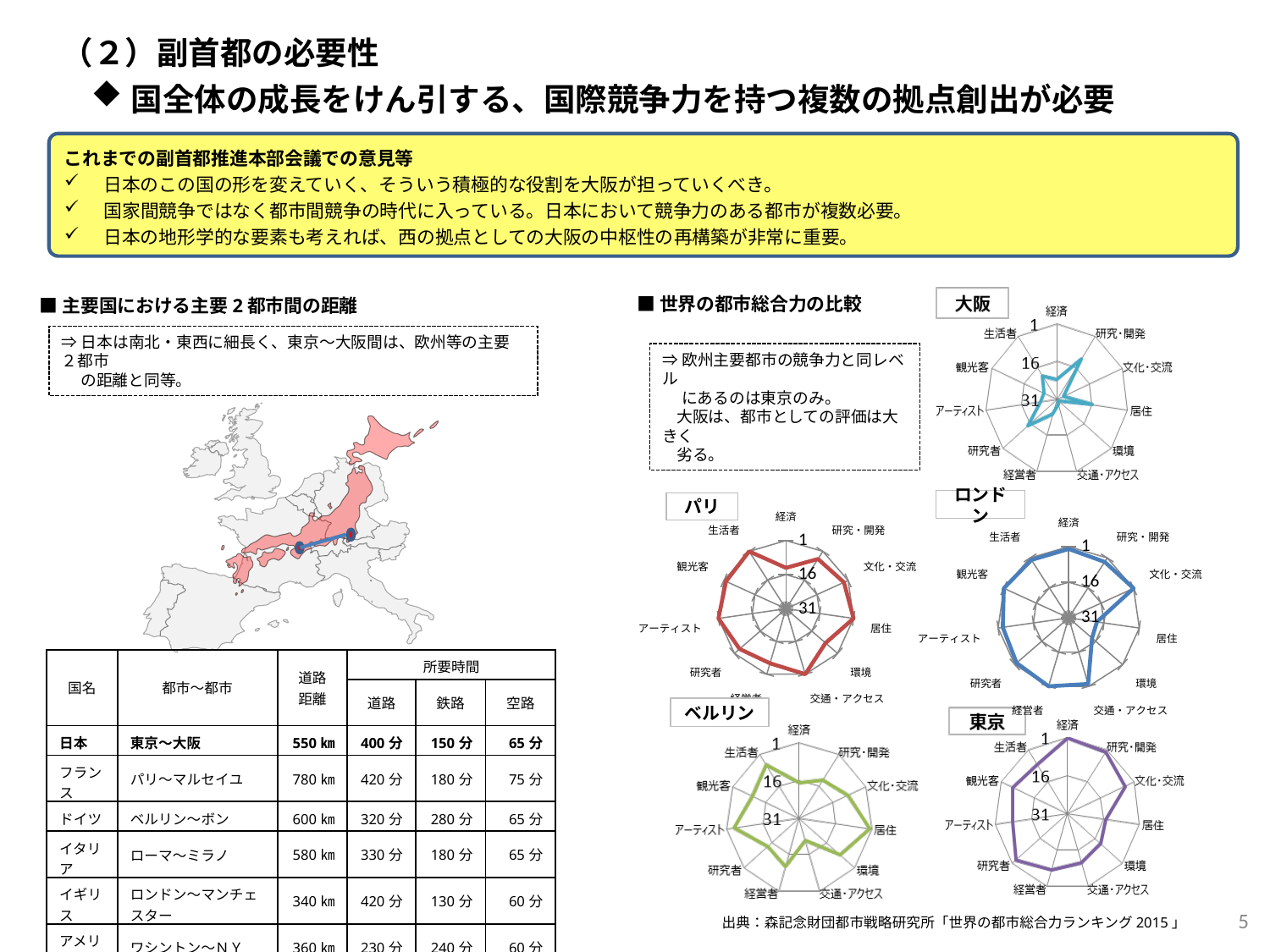
In the 大阪 radar chart, is the value for 観光客 greater or less than 16? greater How many radar charts are shown in the 世界の都市総合力の比較 section? 5 How many axes (categories) does the パリ radar chart have? 11 Which city's radar chart is drawn in purple? 東京 What are the three tick values printed on the axis of the パリ radar chart? 1, 16, 31 In the ベルリン radar chart, is the value for 居住 greater or less than 16? less Which city's radar chart is drawn in green? ベルリン In the 東京 radar chart, is the value for 研究・開発 greater or less than 16? less What kind of chart is used for the 大阪 chart in the 世界の都市総合力の比較 section? radar chart